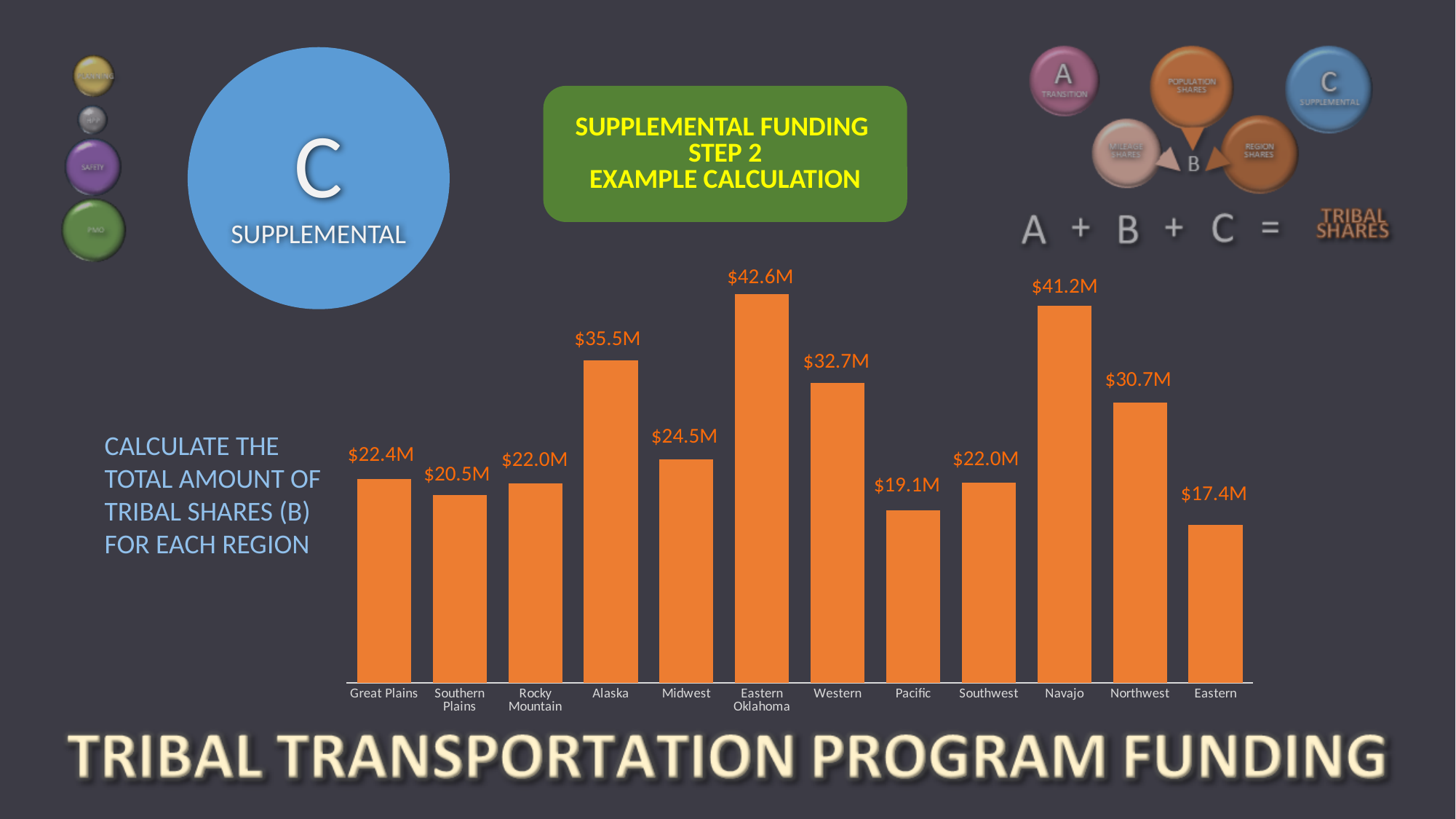
What is the difference between the values for Eastern Oklahoma and Navajo? $1.4M Which region has the highest value? Eastern Oklahoma What is the value for Navajo? $41.2M What is the value for Midwest? $24.5M What kind of chart is shown on the slide? Bar chart What is the value for Pacific? $19.1M Which is larger, the value for Northwest or the value for Western? Western What colour are the bars in the chart? Orange What is the difference between the values for Alaska and Western? $2.8M How many regions are shown on the chart? 12 Which region has the lowest value? Eastern What is the value for Eastern Oklahoma? $42.6M